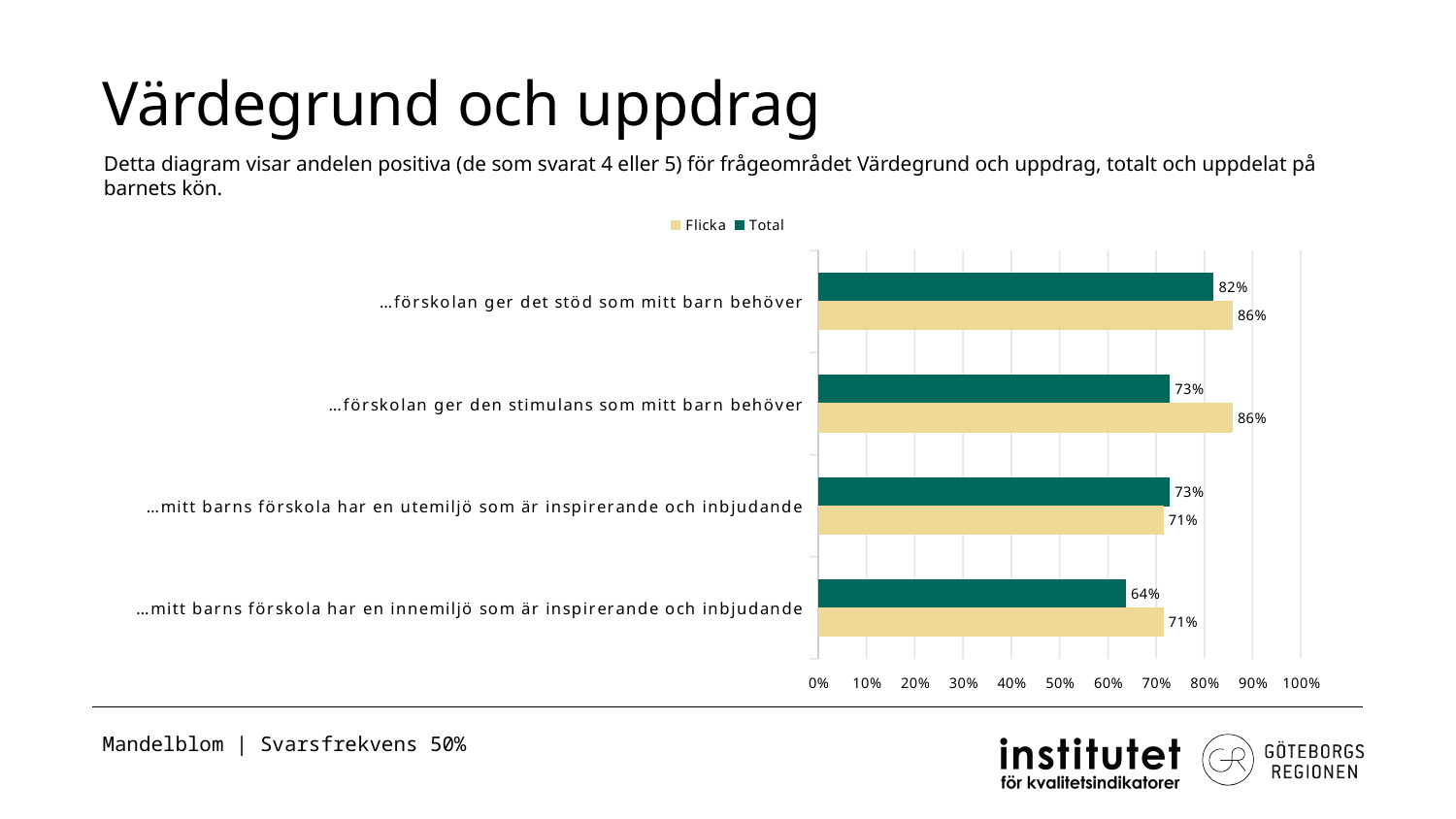
What type of chart is shown on the slide? Bar chart What is the Total value for "…förskolan ger det stöd som mitt barn behöver"? 82% Which category has the highest Total value? …förskolan ger det stöd som mitt barn behöver What is the Flicka value for "…mitt barns förskola har en utemiljö som är inspirerande och inbjudande"? 71% For "…mitt barns förskola har en utemiljö som är inspirerande och inbjudande", which is larger, the Flicka value or the Total value? Total How many series does the legend list? 2 What is the difference between the Flicka and Total values for "…förskolan ger den stimulans som mitt barn behöver"? 13% What is the Total value for "…mitt barns förskola har en innemiljö som är inspirerande och inbjudande"? 64% Which category has the lowest Total value? …mitt barns förskola har en innemiljö som är inspirerande och inbjudande What is the Flicka value for "…förskolan ger den stimulans som mitt barn behöver"? 86% How many categories are shown in the chart? 4 Which series is shown in green in the legend? Total